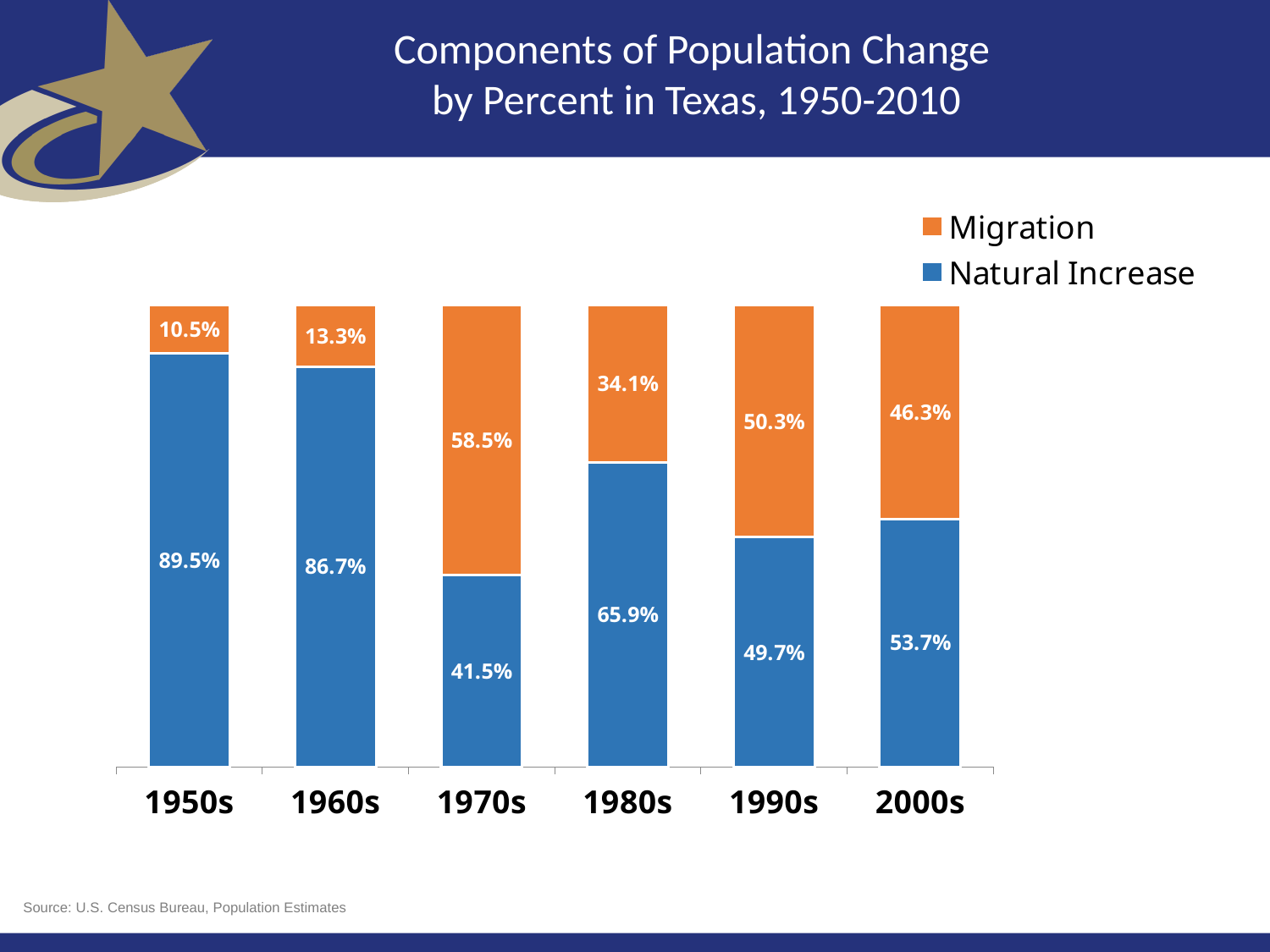
How many series does the legend list? 2 What is the Natural Increase value for the 1950s? 89.5% In which decade is the Migration share highest? 1970s What is the difference between the Natural Increase values for the 1950s and the 1960s? 2.8% Which colour represents Migration in the chart? Orange What is the Natural Increase value for the 2000s? 53.7% In which decade is the Natural Increase share lowest? 1970s What is the Migration value for the 1970s? 58.5% Which is larger in the 1990s, Migration or Natural Increase? Migration What is the Migration value for the 1980s? 34.1% What kind of chart is shown on the slide? Stacked bar chart How many decades are shown on the x axis? 6